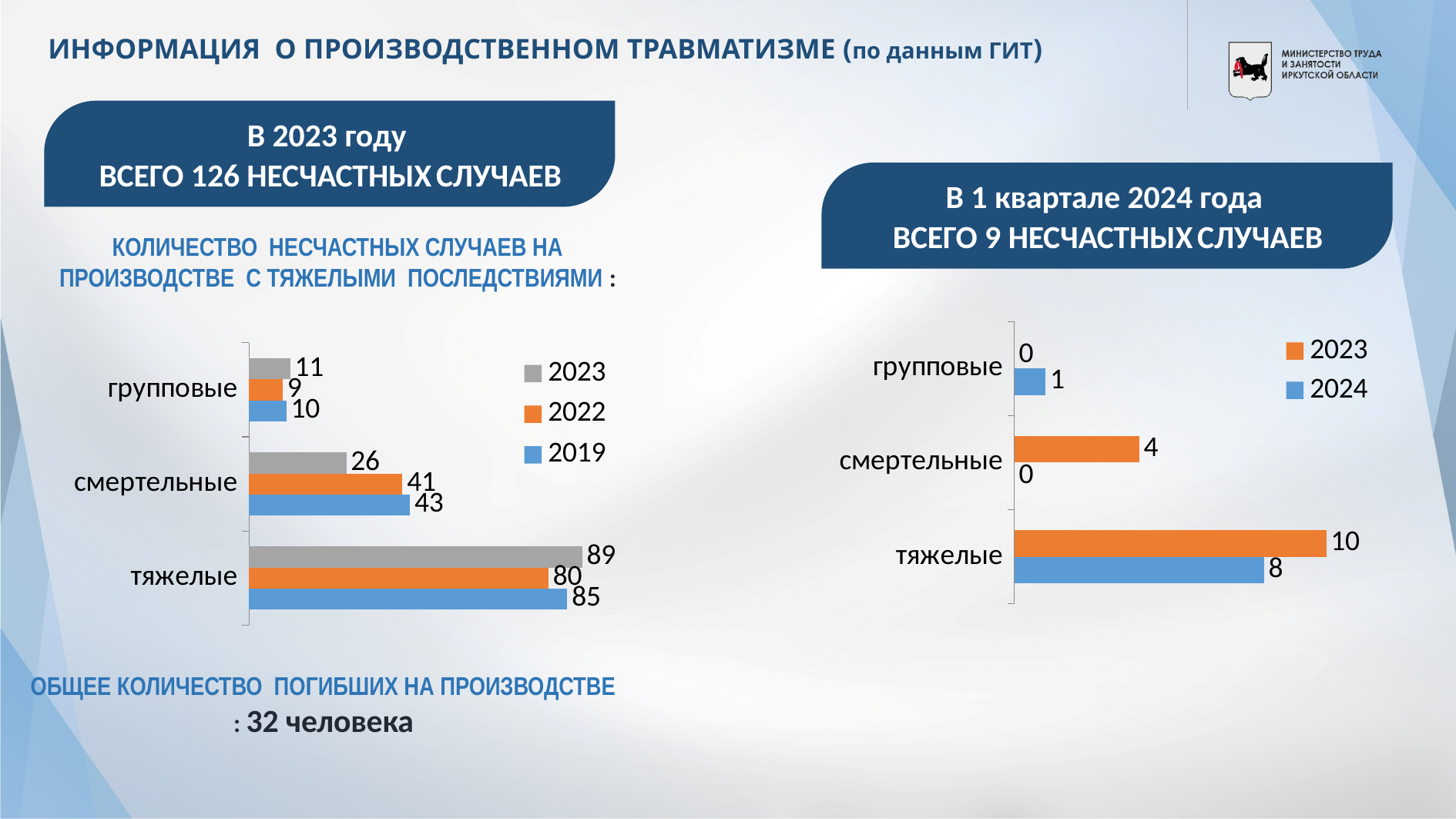
How many series does the legend of the left chart list? 3 In the right chart, what is the value for 'смертельные' in the 2023 series? 4 How many categories are shown in the right chart? 3 What type of chart is the right chart? bar chart In the left chart, which category has the lowest value in the 2022 series? групповые In the left chart, which is larger for 'тяжелые': the 2023 value or the 2022 value? 2023 In the right chart, what is the difference between the 2023 and 2024 values for 'тяжелые'? 2 In the left chart, what is the difference between the 2019 and 2023 values for 'смертельные'? 17 In the left chart, what is the value for 'тяжелые' in the 2019 series? 85 In the left chart, what is the value for 'смертельные' in the 2022 series? 41 In the right chart, what is the value for 'тяжелые' in the 2024 series? 8 In the left chart, which category has the highest value in the 2023 series? тяжелые